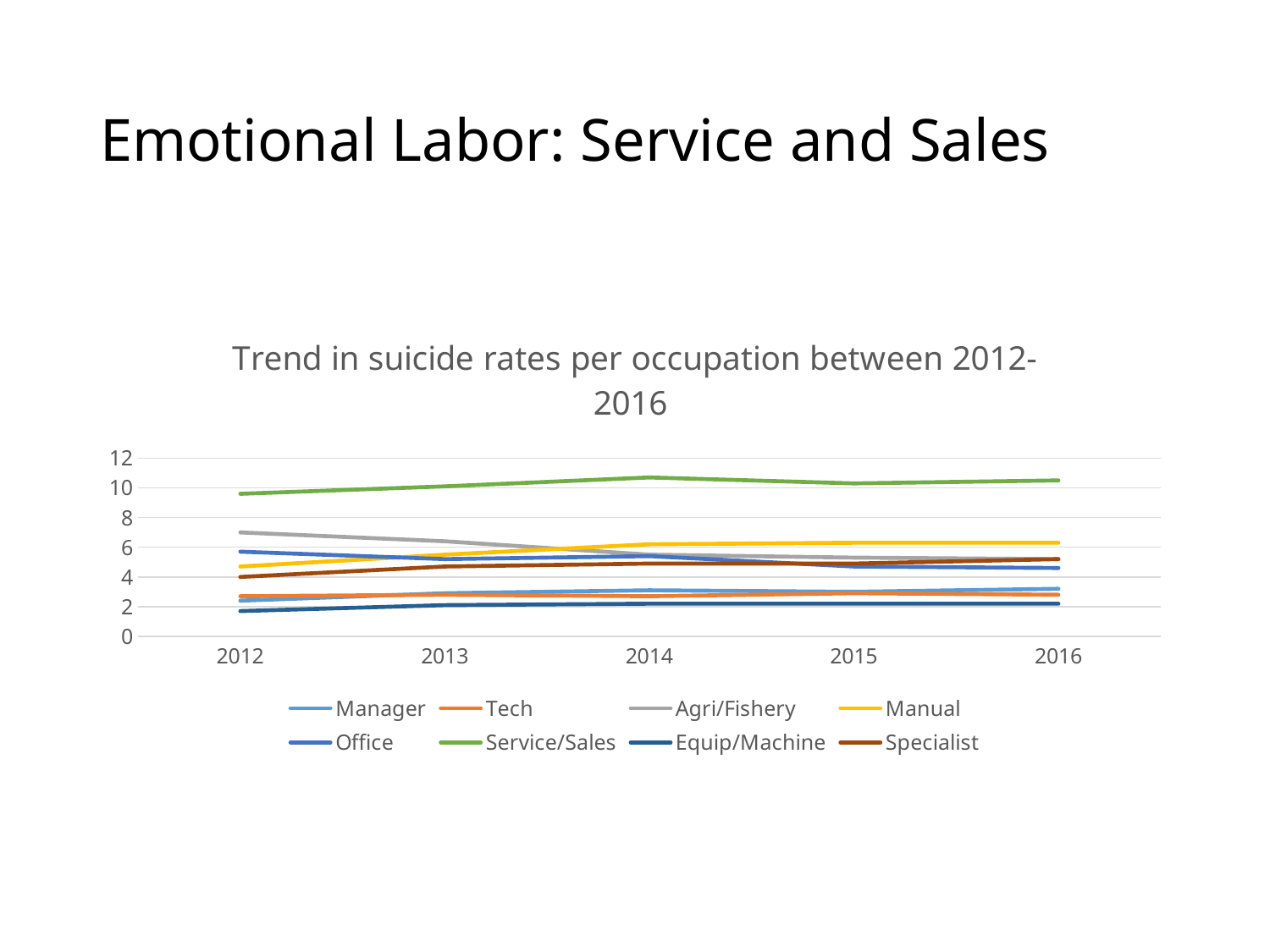
Does the Manual line rise or fall from 2012 to 2016? rise Is the value for Service/Sales in 2014 greater or less than 10? greater Is the value for Equip/Machine in 2012 greater or less than 2? less How many series does the legend list? 8 What is the title of the chart? Trend in suicide rates per occupation between 2012-2016 In 2012, which is higher: Agri/Fishery or Office? Agri/Fishery Is the value for Agri/Fishery in 2012 greater or less than 6? greater What kind of chart is shown on the slide? line chart Which occupation has the lowest suicide rate in 2012? Equip/Machine How many years are plotted along the x axis? 5 Which occupation has the highest suicide rate in 2016? Service/Sales Does the Agri/Fishery line rise or fall from 2012 to 2016? fall